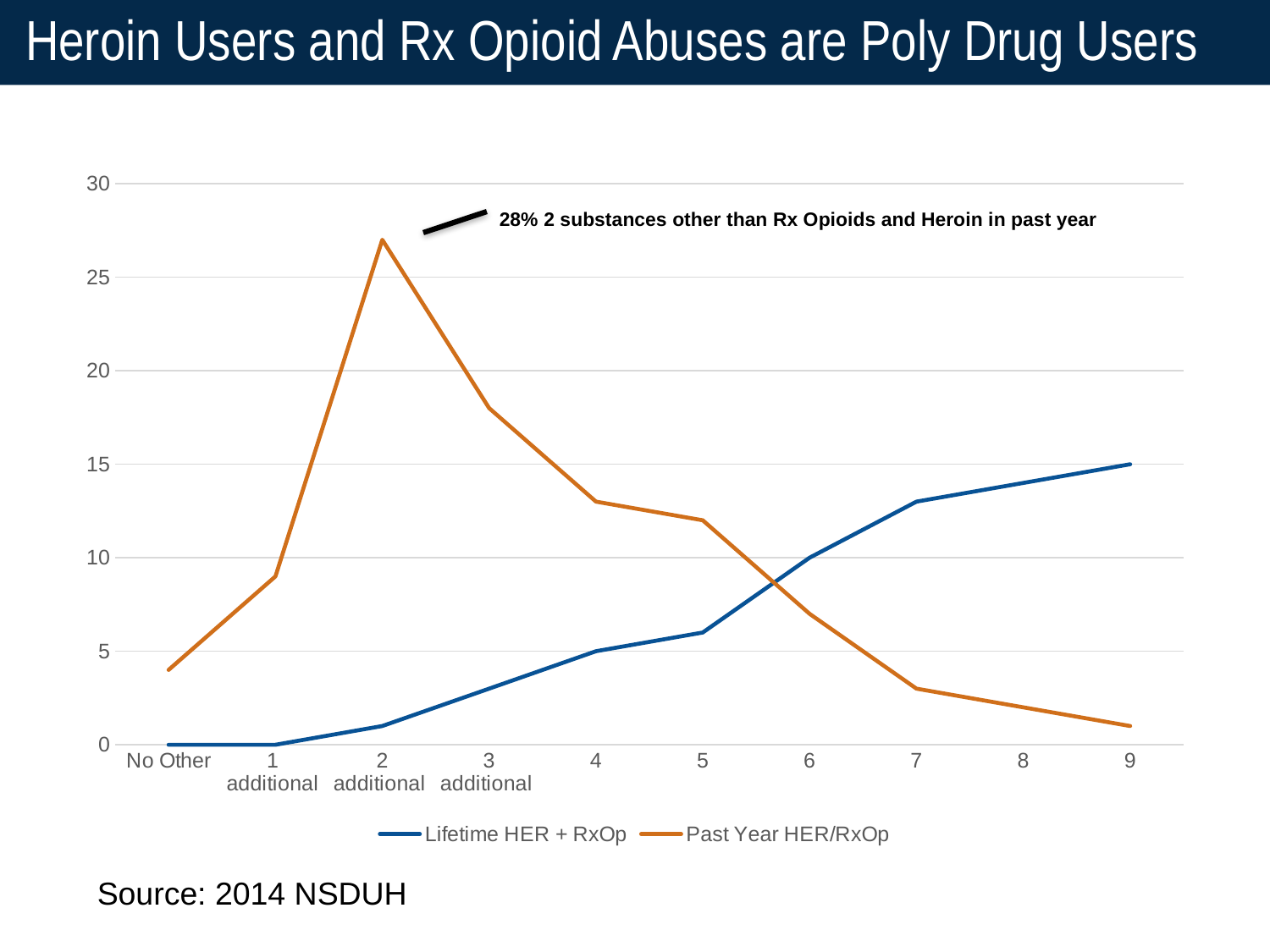
What does the annotation near the peak of the orange line say? 28% 2 substances other than Rx Opioids and Heroin in past year At 3 additional, which series has the larger value, Lifetime HER + RxOp or Past Year HER/RxOp? Past Year HER/RxOp Is the value for Past Year HER/RxOp at 9 greater or less than 5? less Is the value for Past Year HER/RxOp at 2 additional greater or less than 25? greater How many series does the legend list? 2 At which x-axis category does the Lifetime HER + RxOp series reach its highest value? 9 What kind of chart is shown on the slide? Line chart At which x-axis category does the Past Year HER/RxOp series reach its highest value? 2 additional Is the value for Lifetime HER + RxOp at 9 greater or less than 10? greater Does the Lifetime HER + RxOp series rise or fall as you move from No Other to 9 along the x axis? Rise At which x-axis category is the Past Year HER/RxOp series lowest? 9 How many categories are shown along the x axis? 10